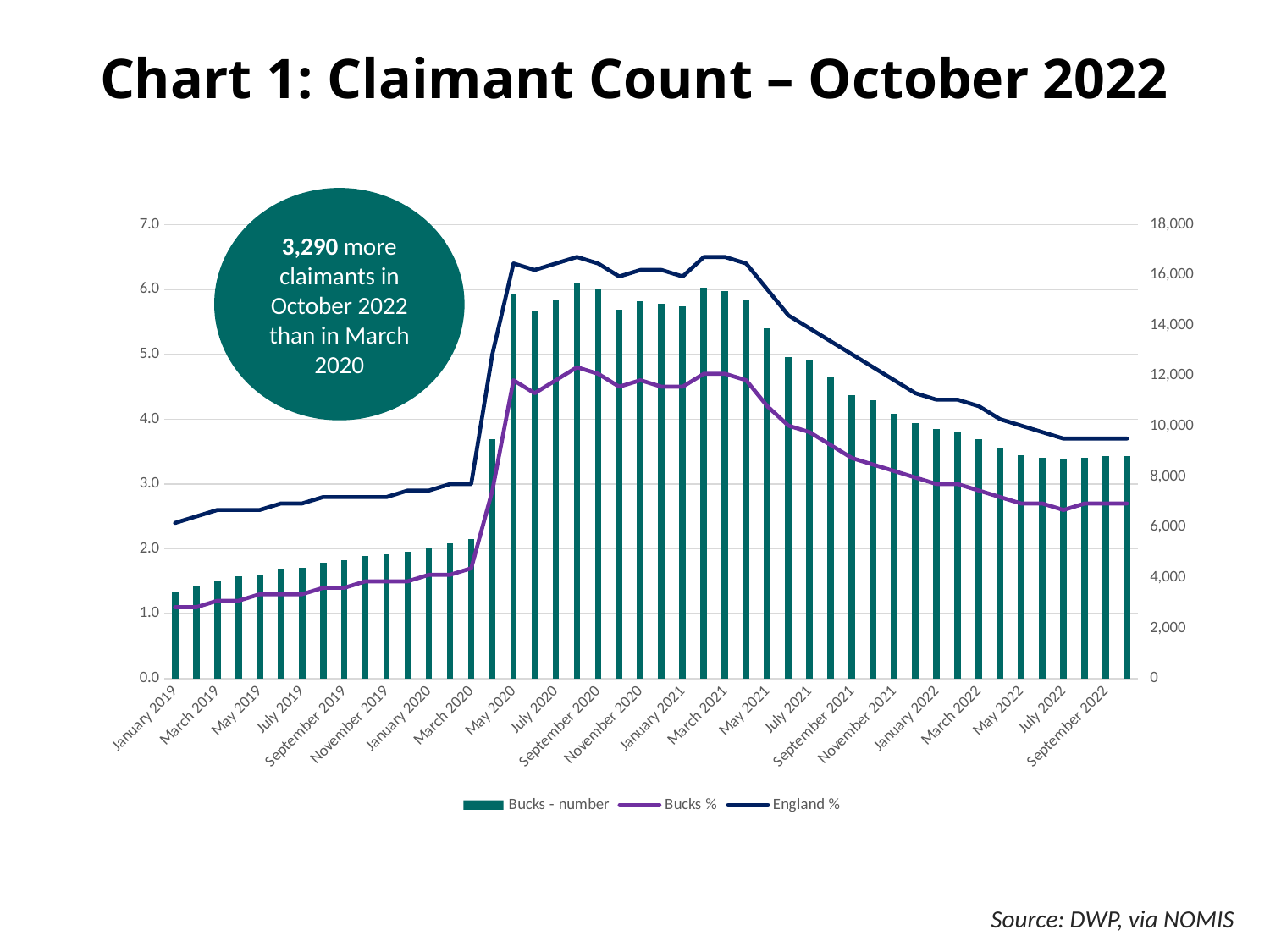
What are the three series named in the legend? Bucks - number, Bucks %, England % Which month has the lowest Bucks - number value? January 2019 Is the Bucks - number value for May 2020 greater or less than 14,000? greater What is the title of the chart? Chart 1: Claimant Count – October 2022 Do the Bucks - number values rise or fall from March 2021 to September 2022? fall In May 2020, which is higher: Bucks % or England %? England % Is the Bucks % value for September 2022 greater or less than 3.0? less How many series does the legend list? 3 Is the Bucks - number value for January 2019 greater or less than 4,000? less According to the callout, how many more claimants were there in October 2022 than in March 2020? 3,290 What kind of chart is this? Combined bar and line chart